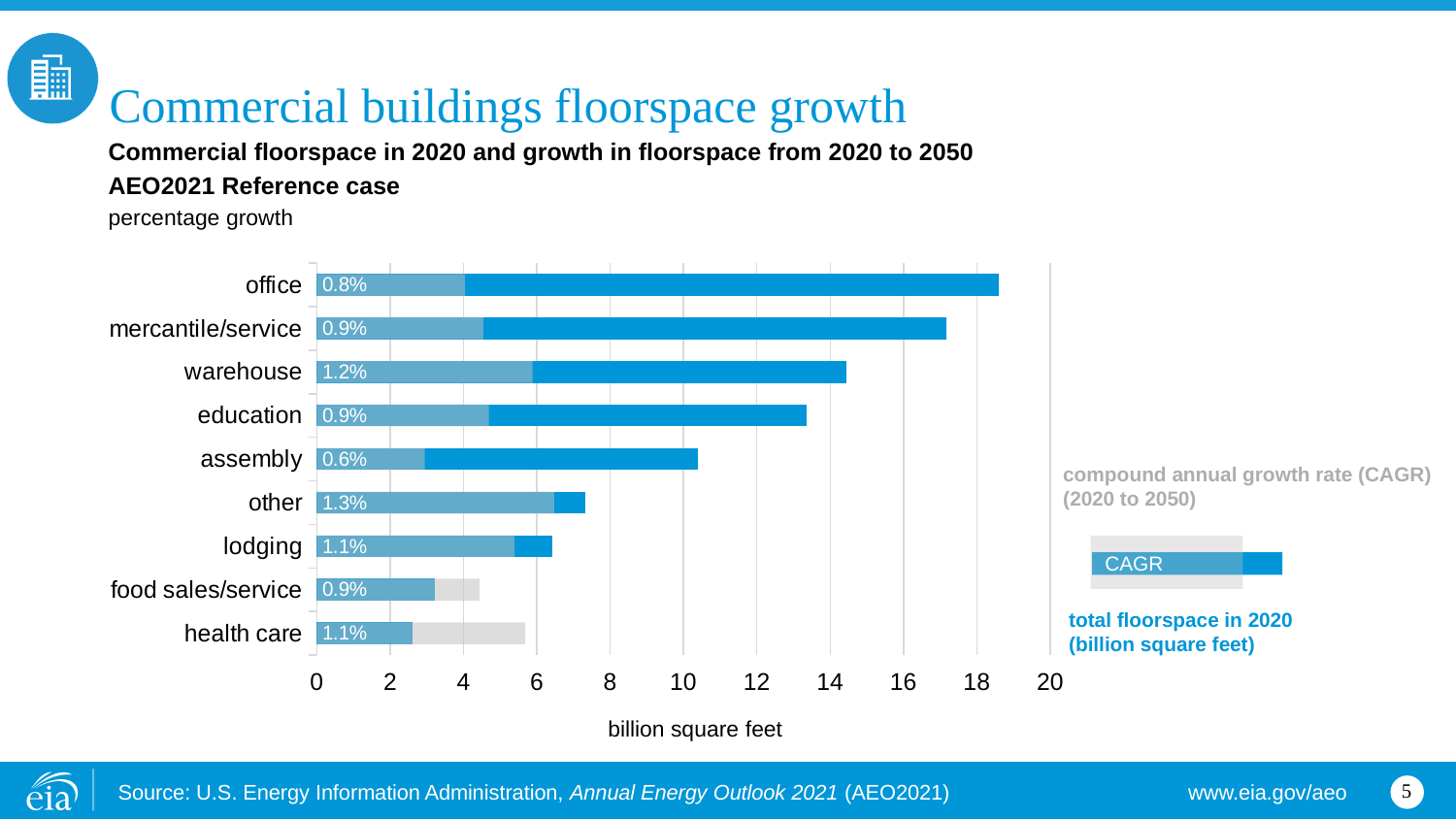
Which building type has the lowest CAGR label? assembly (0.6%) What CAGR is labeled on the warehouse bar? 1.2% What is the compound annual growth rate (CAGR) shown for office buildings? 0.8% What unit is shown on the horizontal axis of the chart? billion square feet What is the CAGR value shown for assembly? 0.6% Which building type has the highest CAGR label? other (1.3%) Is the total floorspace in 2020 for office greater or less than 16 billion square feet? greater What kind of chart is shown on the slide? bar chart Is the total floorspace in 2020 for health care greater or less than 6 billion square feet? less Which has a higher CAGR, warehouse or education? warehouse How many building types are shown in the chart? 9 What is the difference between the CAGR for other and the CAGR for assembly? 0.7 percentage points